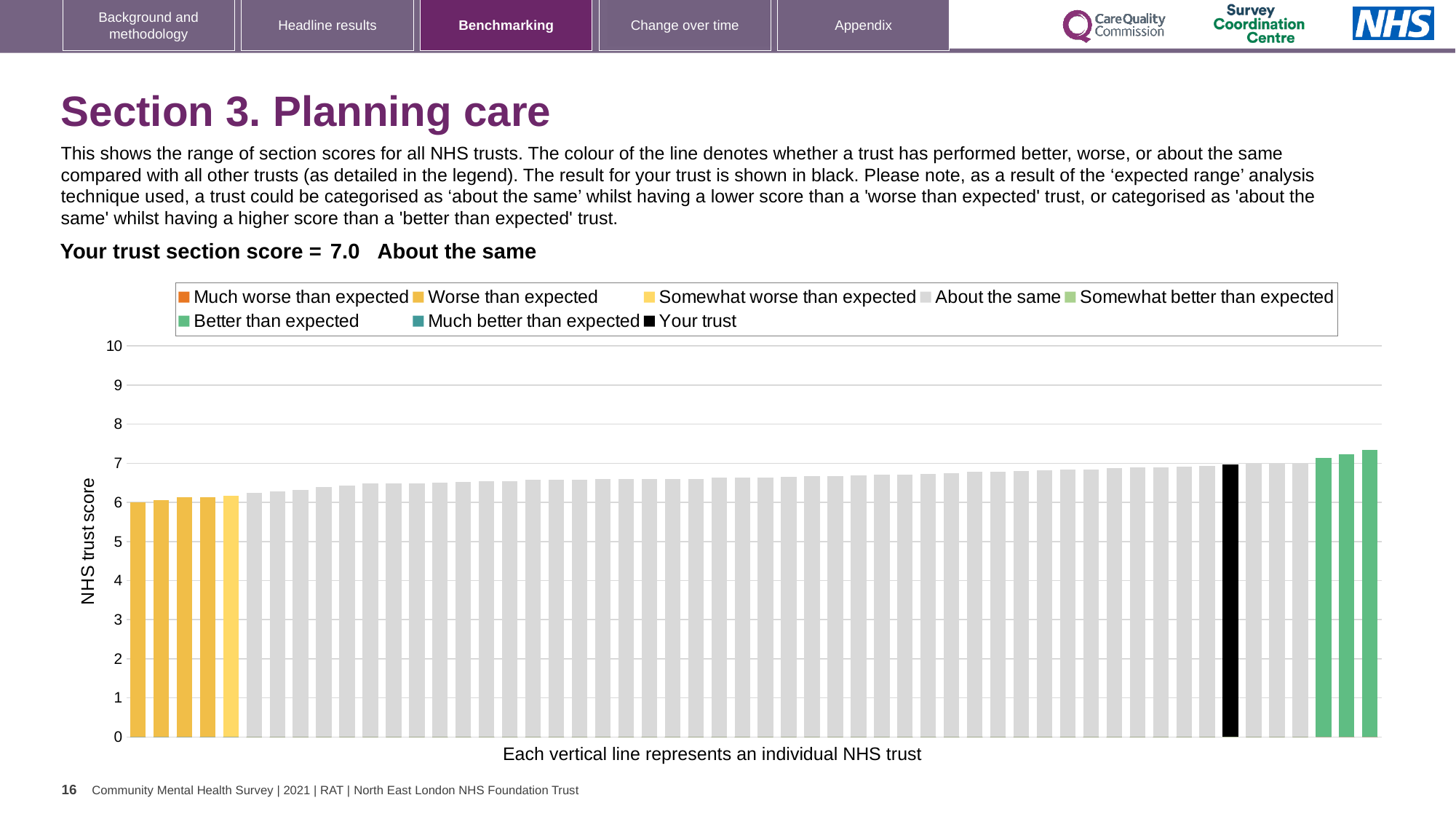
How many bars are shown in the 'Better than expected' green colour? 3 Is the value of the leftmost bar greater or less than 5? greater What kind of chart is shown on the slide? Bar chart Is the value of the tallest bar greater or less than 8? less How many entries does the chart legend list? 8 Is the black bar for your trust taller or shorter than the green bars to its right? Shorter Is the value of the black bar (your trust) greater or less than 6? greater How is your trust's section score categorised compared with other trusts? About the same What is the label on the vertical axis of the chart? NHS trust score What is the trust section score shown for your trust? 7.0 Do the bar values rise or fall from left to right across the chart? Rise What does the caption below the horizontal axis say each vertical line represents? An individual NHS trust